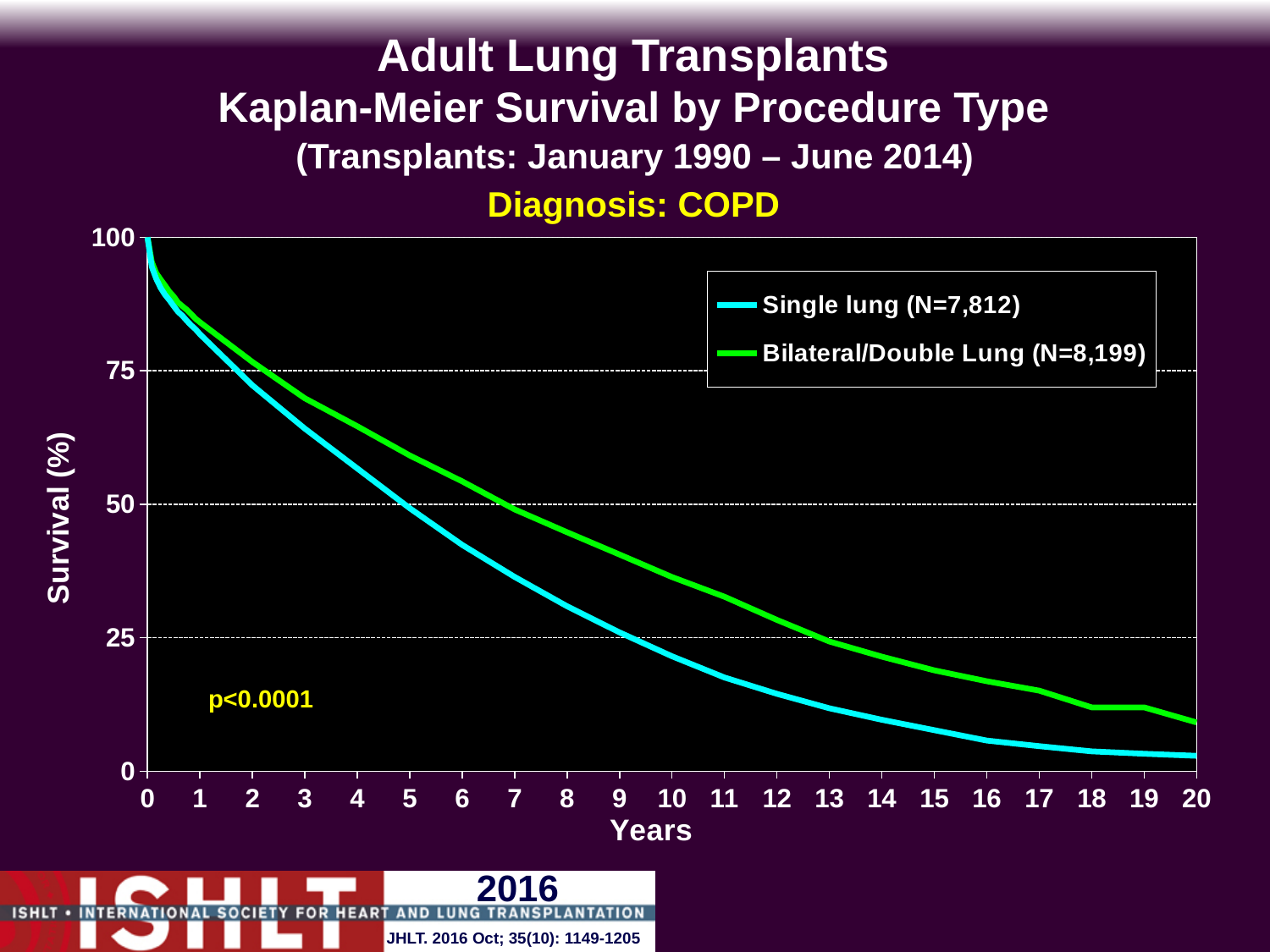
Is the survival value for Bilateral/Double Lung at 5 years greater or less than 50? greater At 10 years, which series has higher survival: Single lung or Bilateral/Double Lung? Bilateral/Double Lung Is the survival value for Single lung at 3 years greater or less than 75? less What p-value is printed on the chart? p<0.0001 How many series does the legend list? 2 Is the survival value for Bilateral/Double Lung at 15 years greater or less than 25? less What is the N shown in the legend for the Single lung series? N=7,812 Do the survival curves rise or fall as years increase? fall What kind of chart is shown on the slide? line chart